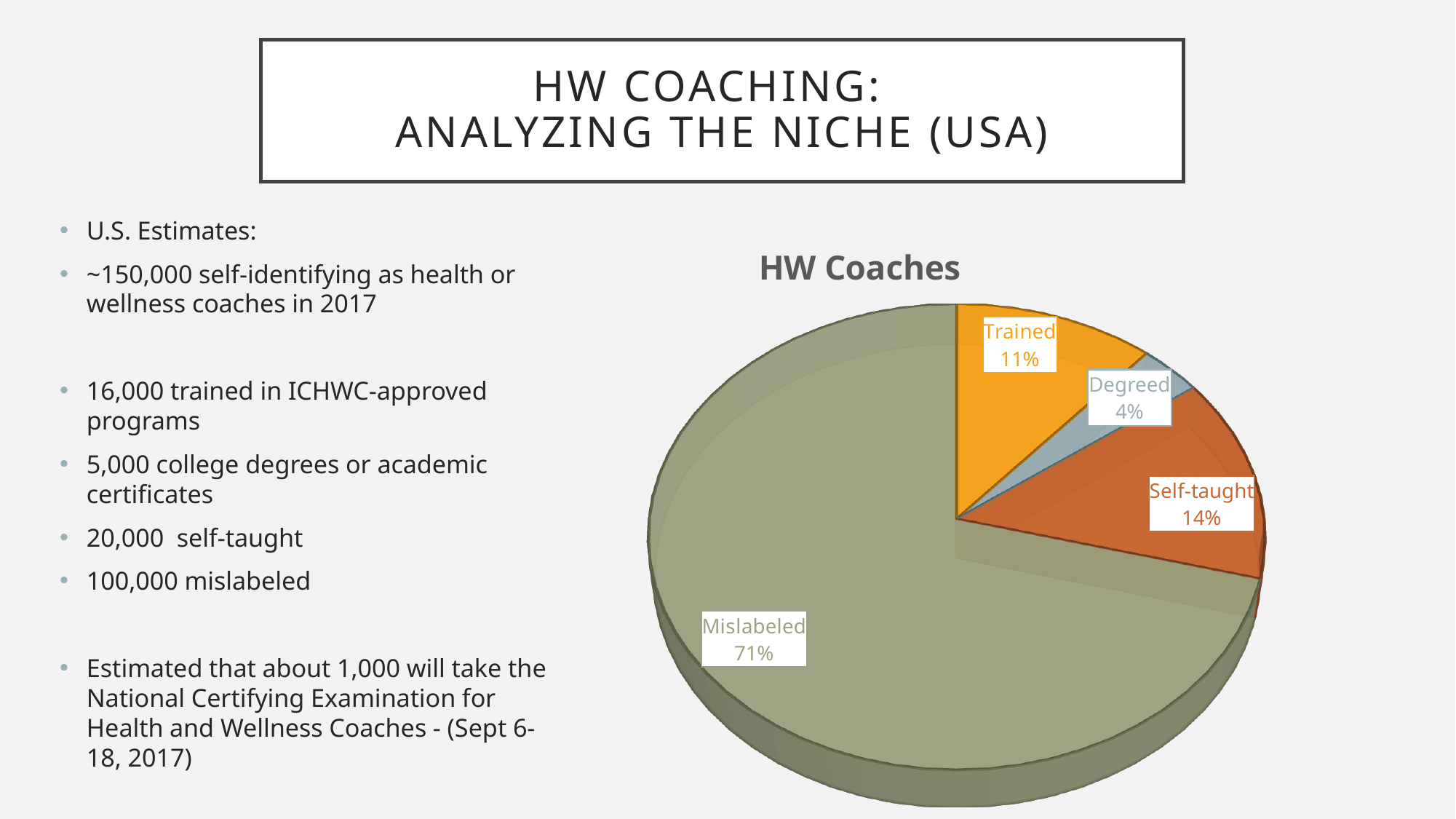
What percentage of the pie is labeled Trained? 11% How many slices does the pie chart have? 4 What percentage of the pie is labeled Mislabeled? 71% What is the difference in percentage points between the Self-taught and Degreed slices? 10 Which slice of the pie is the largest? Mislabeled Which is larger, the Self-taught slice or the Trained slice? Self-taught What percentage of the pie is labeled Self-taught? 14% What is the title of the chart? HW Coaches What percentage of the pie is labeled Degreed? 4% Which slice of the pie is the smallest? Degreed What type of chart is shown on the slide? Pie chart What is the combined share of the Trained and Degreed slices? 15%